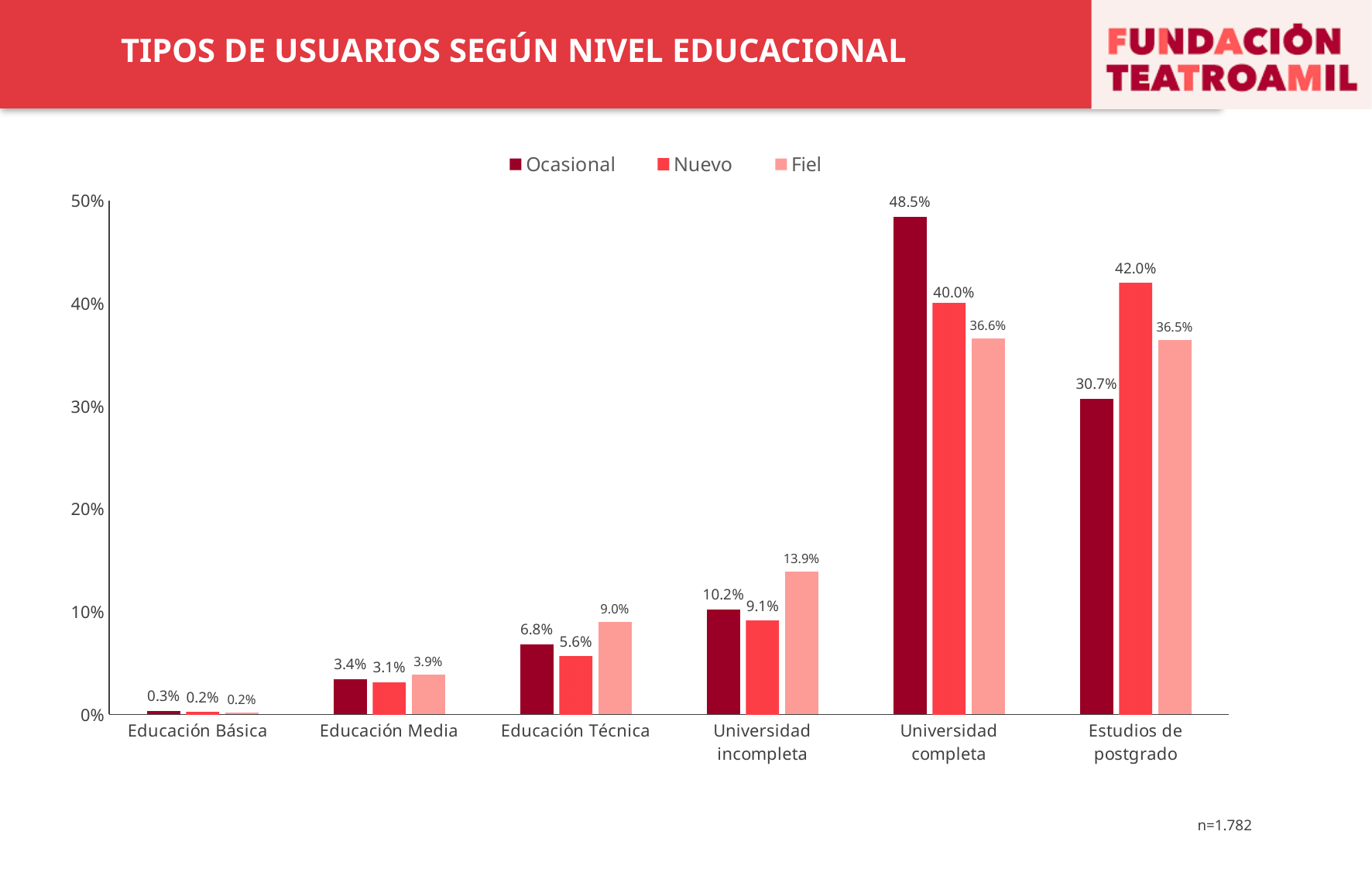
What is the sample size noted on the slide? n=1.782 What is the Nuevo value for Educación Técnica? 5.6% Which education level has the highest Ocasional value? Universidad completa Which education level has the lowest Fiel value? Educación Básica What is the Fiel value for Universidad incompleta? 13.9% For Estudios de postgrado, which is larger: the Ocasional value or the Nuevo value? Nuevo What is the difference between the Ocasional and Nuevo values for Universidad completa? 8.5% How many education level categories are shown on the x axis? 6 How many series does the legend list? 3 What is the Nuevo value for Estudios de postgrado? 42.0% What is the Ocasional value for Universidad completa? 48.5% What kind of chart is shown on the slide? Bar chart